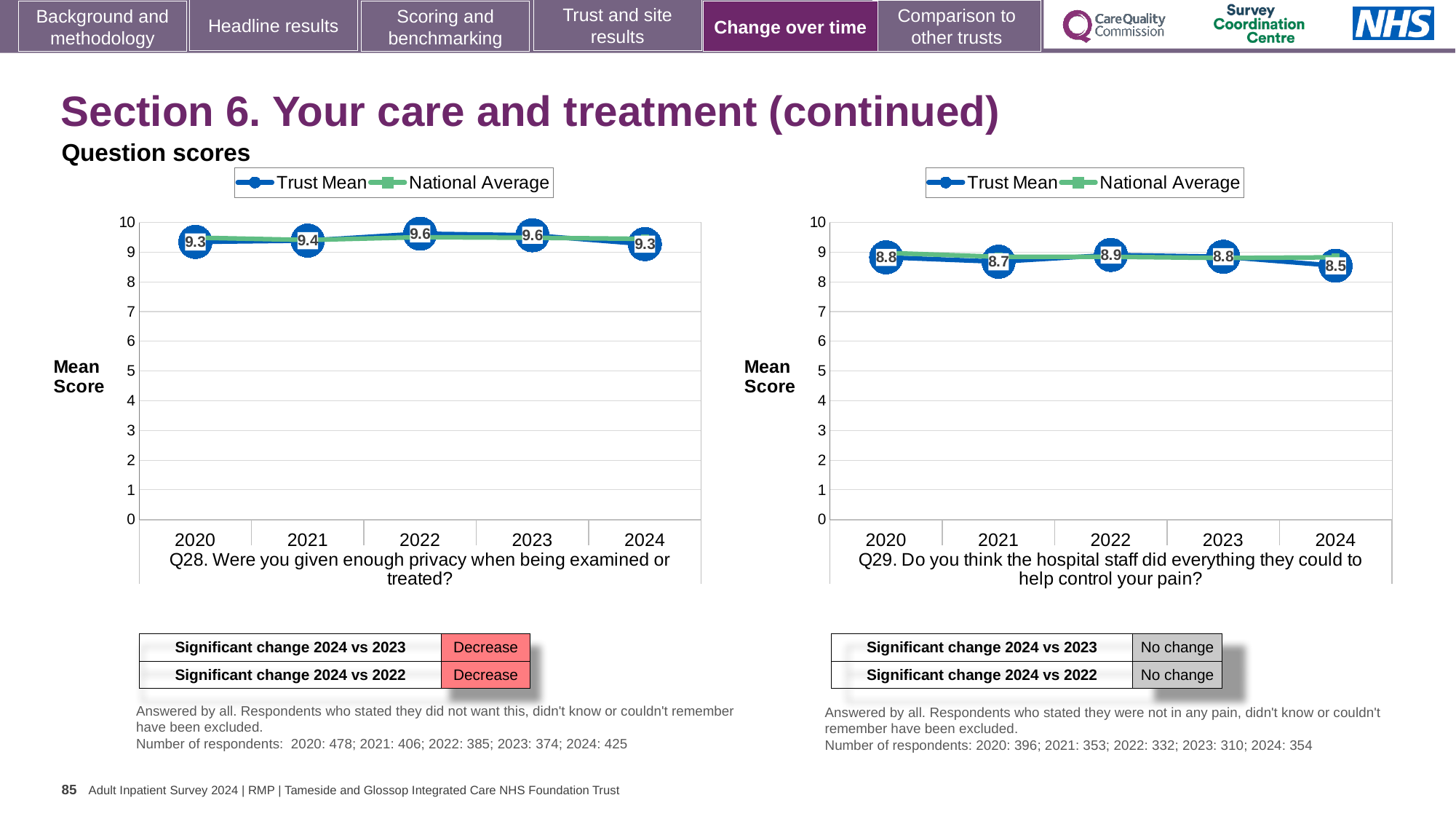
In the Q29 chart on the right, which year has the larger Trust Mean score, 2020 or 2024? 2020 In the Q28 chart on the left, what is the difference between the Trust Mean scores for 2022 and 2024? 0.3 In the Q29 chart on the right, which year has the lowest Trust Mean score? 2024 What kind of chart is the Q28 chart on the left? Line chart In the Q29 chart on the right, which year has the highest Trust Mean score? 2022 In the Q29 chart on the right, what is the difference between the Trust Mean scores for 2022 and 2024? 0.4 How many years are plotted on the x axis of the Q28 chart on the left? 5 In the Q29 chart on the right, is the Trust Mean score for 2024 greater or less than 9? less In the Q29 chart on the right, what is the Trust Mean score for 2021? 8.7 In the Q28 chart on the left, what is the Trust Mean score for 2022? 9.6 In the Q28 chart on the left, what is the Trust Mean score for 2024? 9.3 How many series does the legend of the Q29 chart on the right list? 2